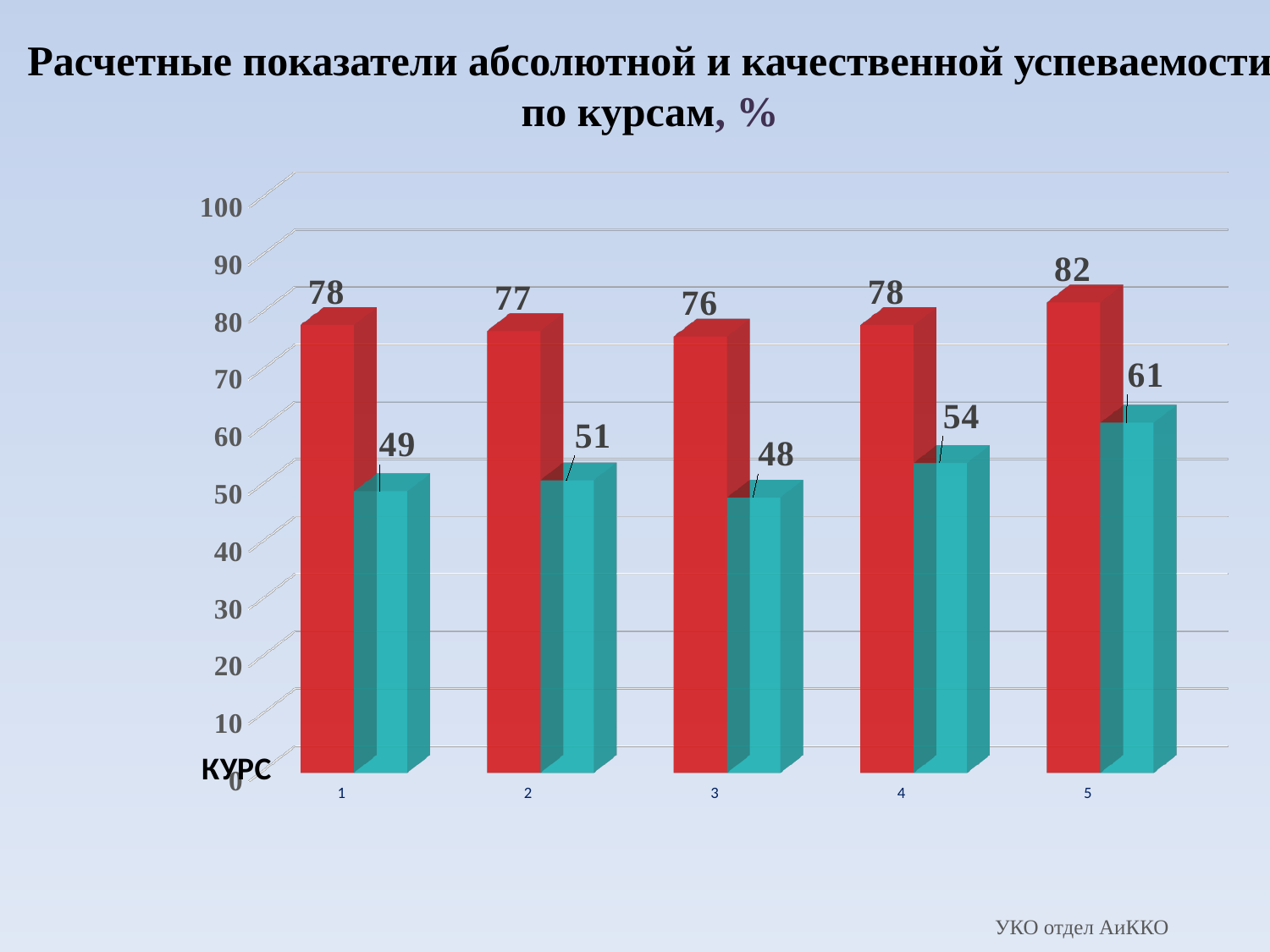
Is the value of the red bar for course 3 greater or less than 70? greater Which course has the highest red bar? 5 What is the value of the teal bar for course 3? 48 How many courses are shown on the x axis? 5 What is the value of the teal bar for course 4? 54 What kind of chart is shown on the slide? bar chart Which course has the lowest teal bar? 3 What is the label of the x axis? КУРС What is the value of the red bar for course 5? 82 Which is larger: the teal bar for course 4 or the teal bar for course 2? course 4 What is the difference between the red and teal bars for course 1? 29 What is the difference between the teal bar for course 5 and the teal bar for course 2? 10